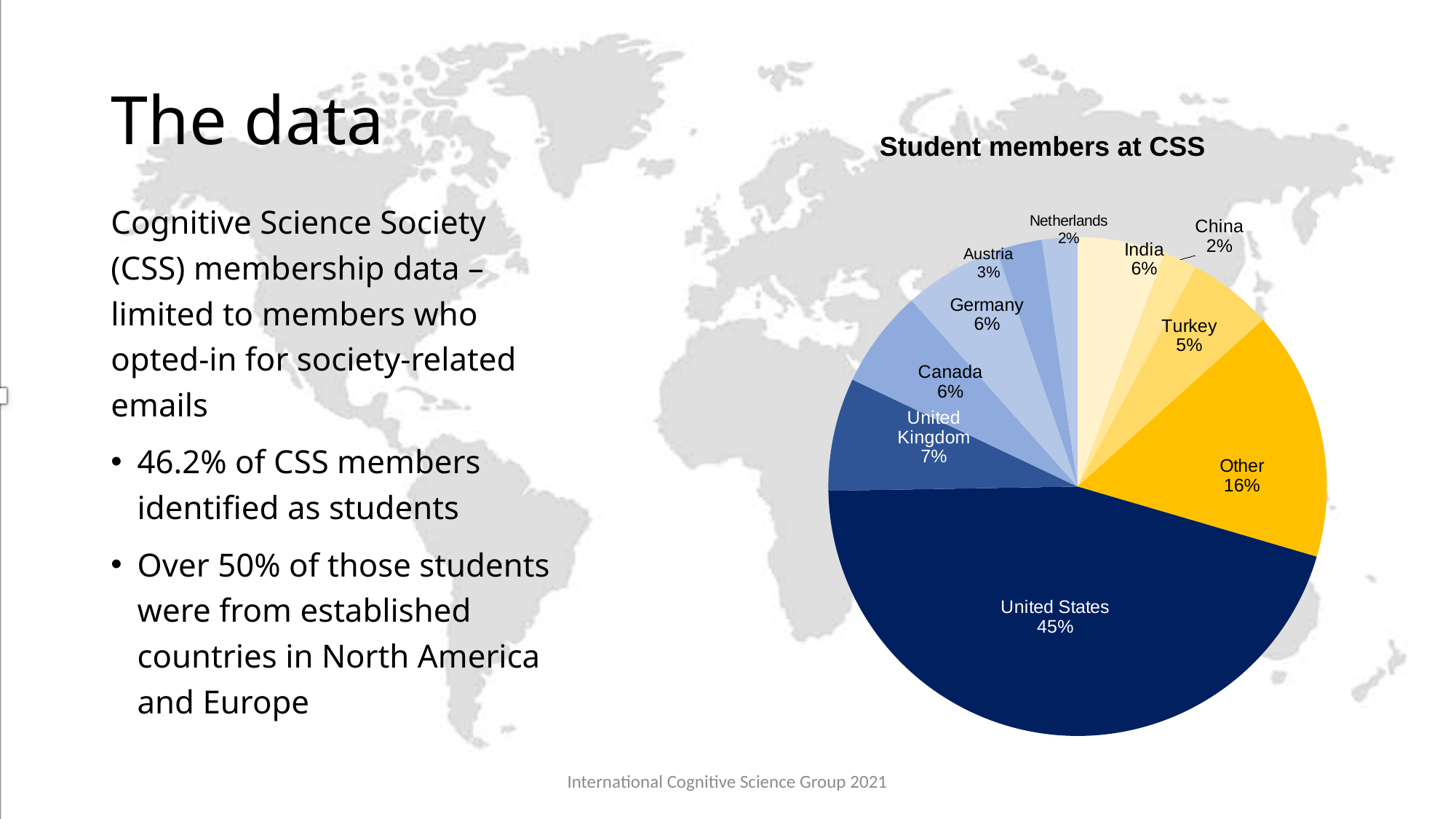
Which country has the largest share of student members at CSS? United States Which slice is larger: Canada or Austria? Canada How many slices does the pie chart have? 10 What is the difference in percentage points between the United States and Other slices? 29 What share of student members at CSS is from the United Kingdom? 7% What share of student members at CSS is from Turkey? 5% What is the title of the chart? Student members at CSS What type of chart is shown on the slide? Pie chart What is the combined share of the Netherlands and China slices? 4% What share of student members at CSS is from India? 6% What share of student members at CSS is from Austria? 3% What share of student members at CSS is from the United States? 45%